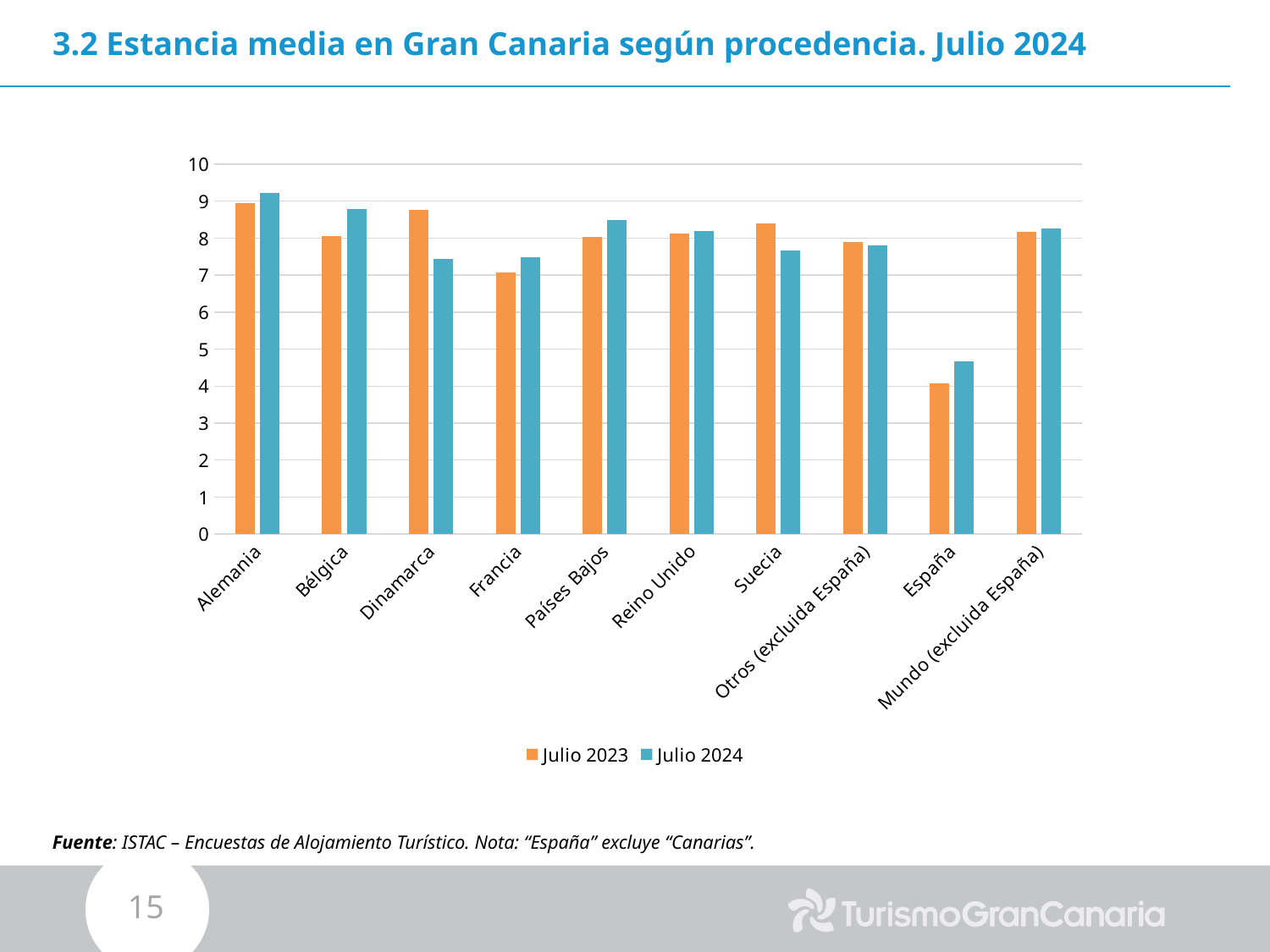
Which category has the lowest value for Julio 2024? España Which category has the highest value for Julio 2024? Alemania Which category has the lowest value for Julio 2023? España How many series does the legend list? 2 What kind of chart is shown on the slide? bar chart Is the Julio 2023 value for España greater or less than 5? less For Dinamarca, which is larger: the Julio 2023 value or the Julio 2024 value? Julio 2023 How many origin categories are shown on the x axis? 10 For Bélgica, which is larger: the Julio 2023 value or the Julio 2024 value? Julio 2024 Is the Julio 2024 value for Dinamarca greater or less than 8? less Is the Julio 2024 value for Alemania greater or less than 9? greater What are the two series named in the legend? Julio 2023 and Julio 2024